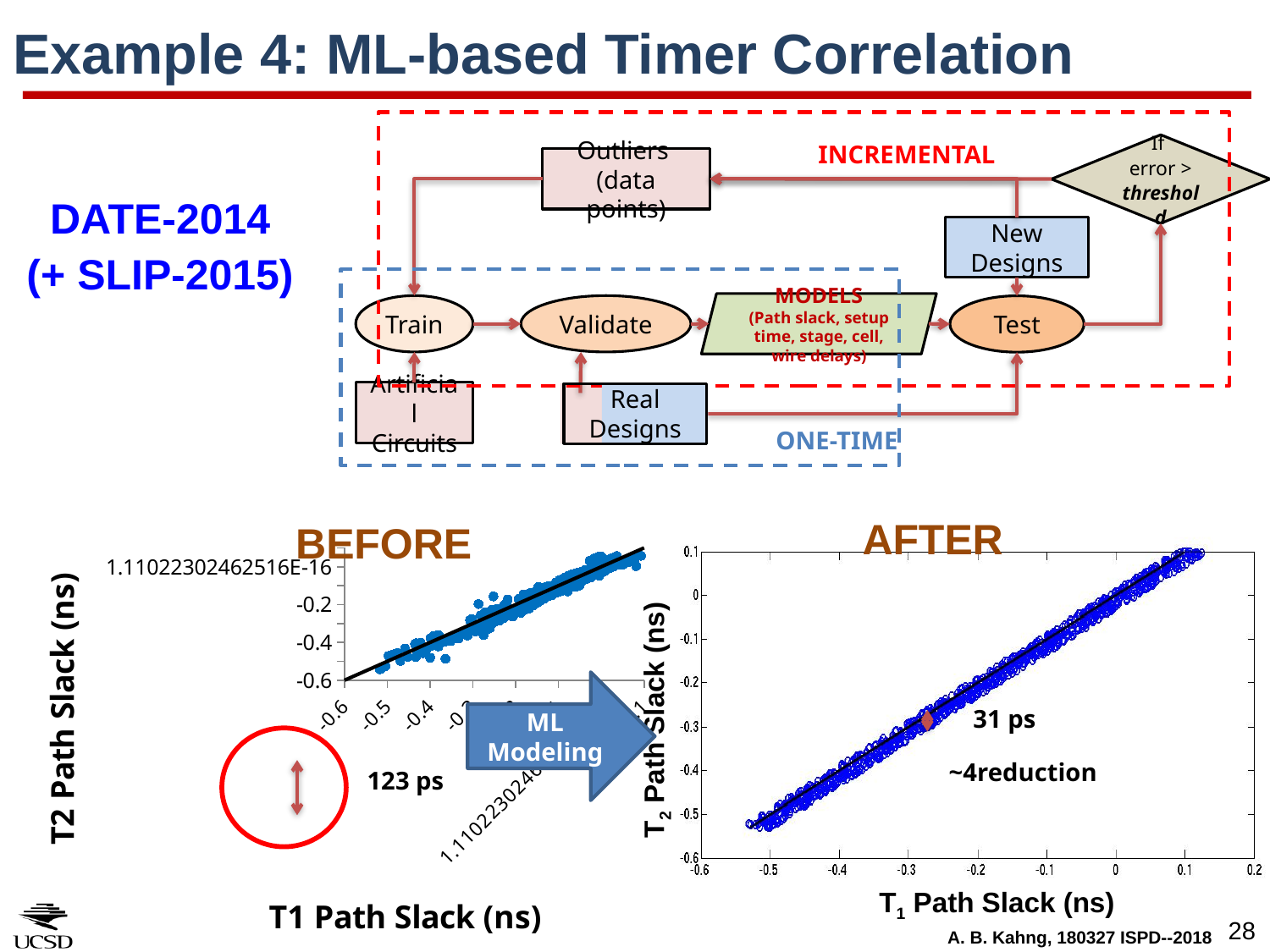
In the AFTER chart, is the highest T1 Path Slack value of the plotted points greater or less than 0? greater What kind of chart is the AFTER chart? scatter chart What is the difference between the annotated errors of the BEFORE chart (123 ps) and the AFTER chart (31 ps)? 92 ps Which chart shows the larger annotated error, BEFORE (123 ps) or AFTER (31 ps)? BEFORE What error value is annotated on the BEFORE chart? 123 ps What is the y-axis label of the BEFORE chart? T2 Path Slack (ns) What error value is annotated on the AFTER chart? 31 ps In the BEFORE chart, do the T2 Path Slack values rise or fall as T1 Path Slack increases? rise In the AFTER chart, is the lowest T1 Path Slack value of the plotted points greater or less than -0.4? less What is the x-axis label of the AFTER chart? T1 Path Slack (ns) What kind of chart is the BEFORE chart? scatter chart In the AFTER chart, do the T2 Path Slack values rise or fall as T1 Path Slack increases? rise